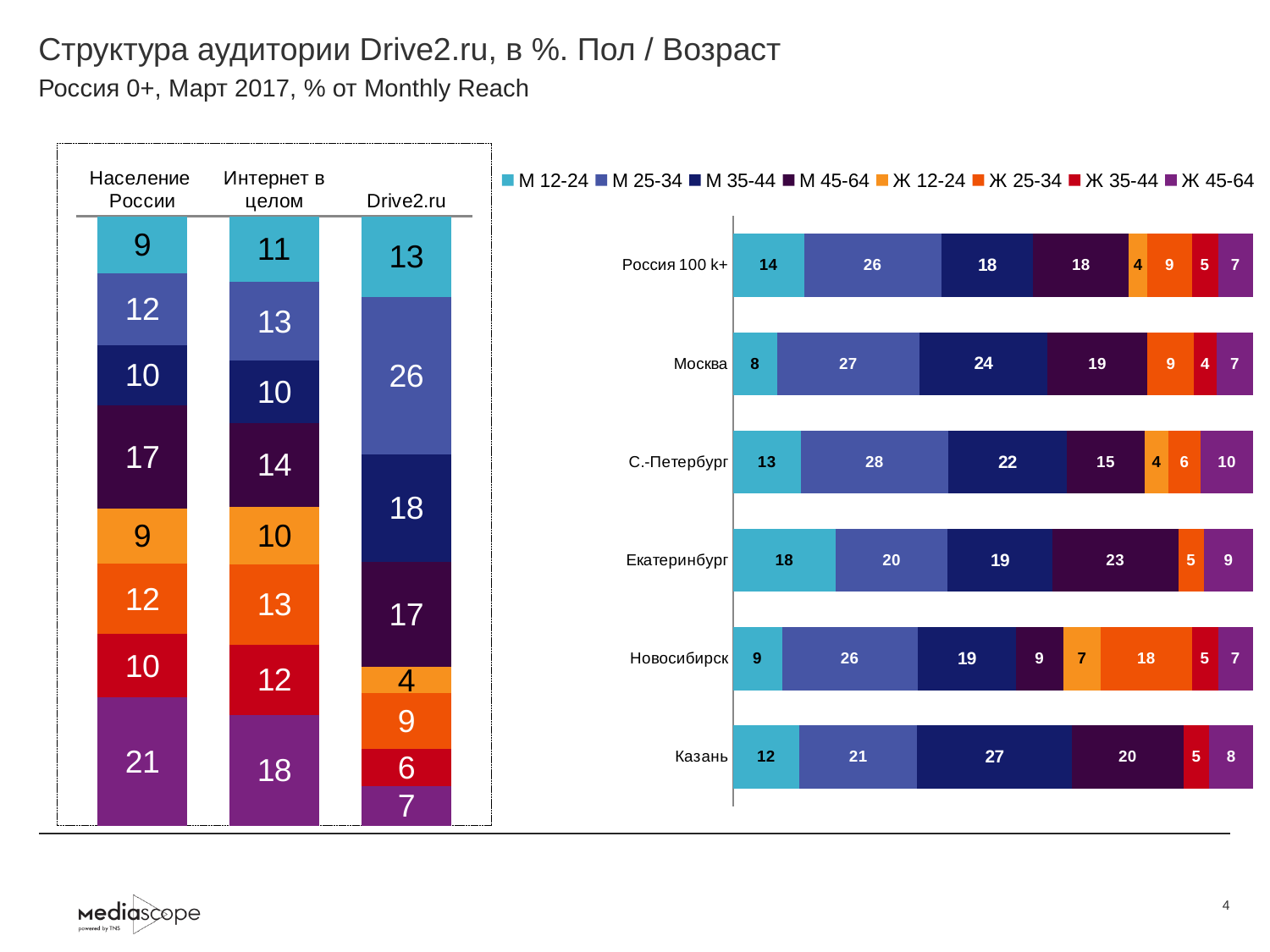
On the right chart, what is the value of the Ж 25-34 segment for Новосибирск? 18 How many series does the legend of the right chart list? 8 On the left chart, what is the value of the М 25-34 segment for Drive2.ru? 26 On the left chart, which of the three bars has the largest М 25-34 segment? Drive2.ru On the right chart, which city has the highest М 12-24 value? Екатеринбург On the left chart, what is the difference between the Ж 45-64 segments for Население России and Drive2.ru? 14 How many city/region categories are shown on the right chart? 6 What type of chart is the right chart? Stacked bar chart On the left chart, what is the value of the Ж 45-64 segment for Население России? 21 On the right chart, what is the value of the М 35-44 segment for Казань? 27 On the right chart, which city has the lowest М 12-24 value? Москва On the left chart, which is larger: the М 35-44 segment for Drive2.ru or for Интернет в целом? Drive2.ru